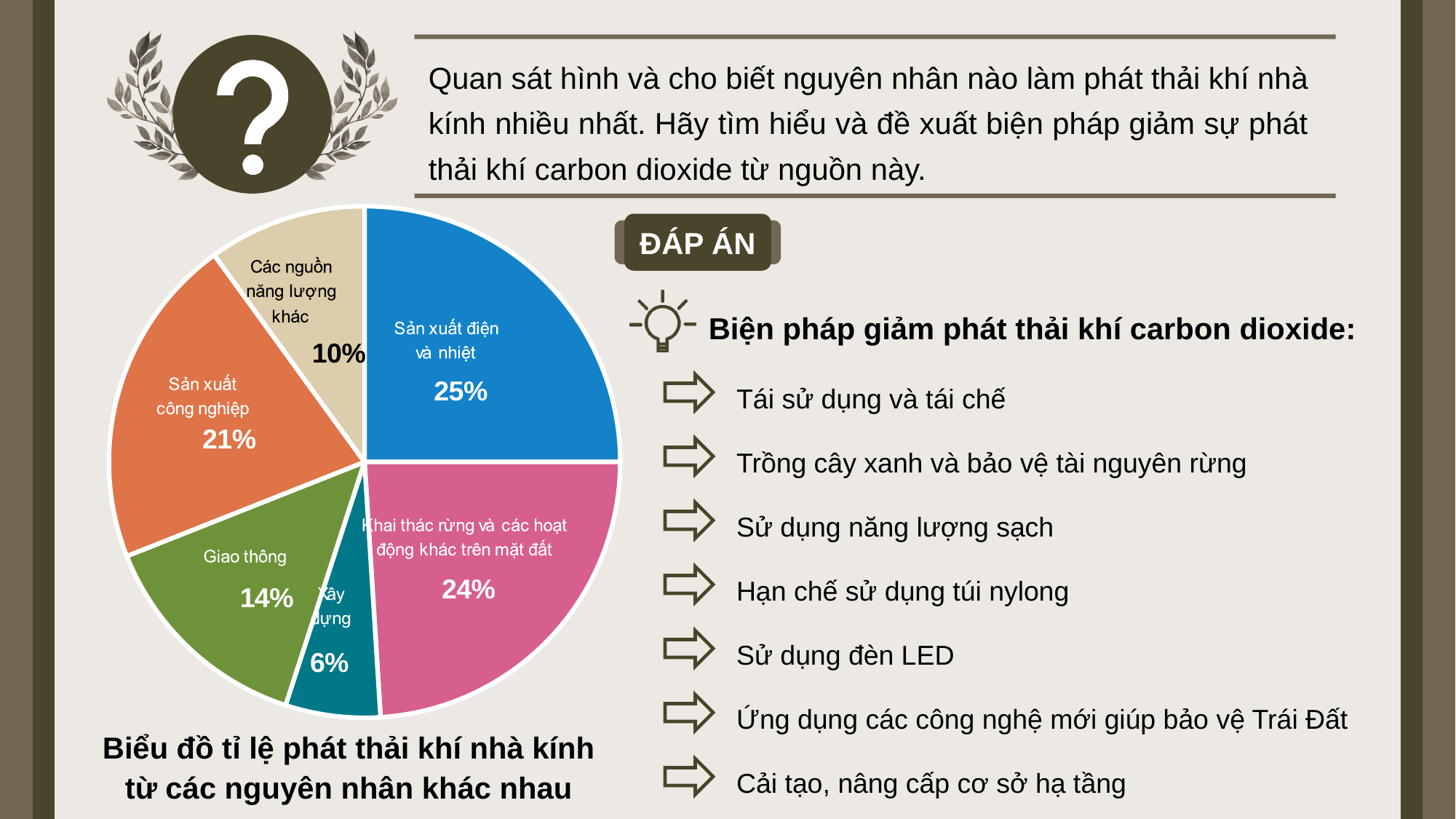
How many slices does the pie chart have? 6 What percentage of greenhouse gas emissions comes from "Sản xuất điện và nhiệt"? 25% Which is larger: the share for "Giao thông" or the share for "Các nguồn năng lượng khác"? Giao thông What kind of chart is shown on the slide? Pie chart What percentage is shown for "Sản xuất công nghiệp"? 21% Which category has the smallest share of the pie? Xây dựng What is the title of the chart? Biểu đồ tỉ lệ phát thải khí nhà kính từ các nguyên nhân khác nhau Which category has the largest share of the pie? Sản xuất điện và nhiệt What percentage is shown for "Giao thông"? 14% What percentage is shown for "Xây dựng"? 6% What is the difference between the shares of "Sản xuất công nghiệp" and "Các nguồn năng lượng khác"? 11% What is the combined share of "Sản xuất điện và nhiệt" and "Khai thác rừng và các hoạt động khác trên mặt đất"? 49%